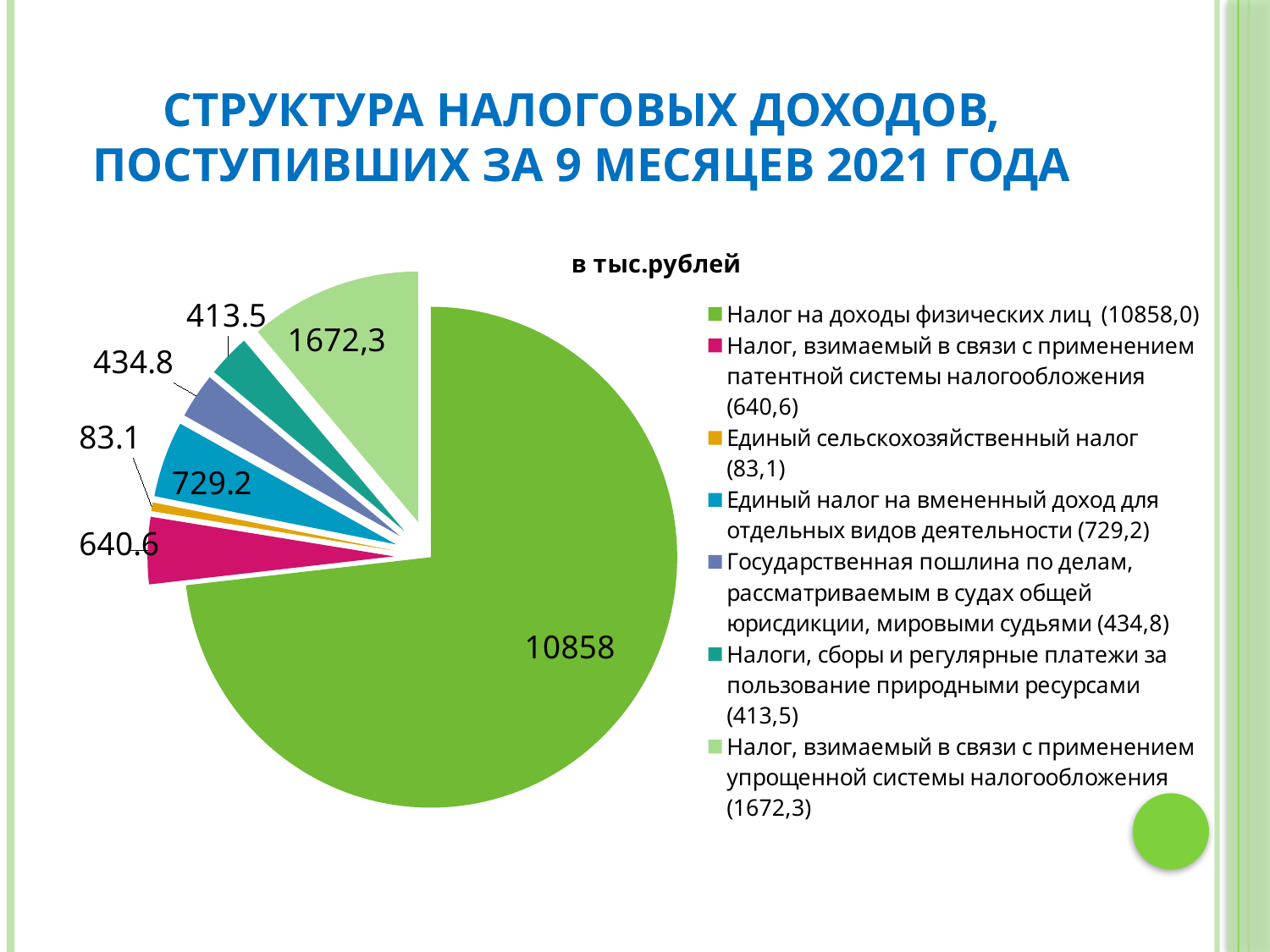
What type of chart is shown on the slide? Pie chart Which is larger: the value for Государственная пошлина по делам, рассматриваемым в судах общей юрисдикции (434.8) or the value for Налоги, сборы и регулярные платежи за пользование природными ресурсами (413.5)? Государственная пошлина по делам, рассматриваемым в судах общей юрисдикции What is the value of the slice for Налог, взимаемый в связи с применением упрощенной системы налогообложения? 1672,3 In what units are the values on the chart given, according to the label above the legend? в тыс.рублей What is the difference between the value for Налог на доходы физических лиц (10858) and the value for Налог, взимаемый в связи с применением упрощенной системы налогообложения (1672,3)? 9185.7 What is the difference between the value for Единый налог на вмененный доход (729.2) and the value for Налог, взимаемый в связи с применением патентной системы налогообложения (640.6)? 88.6 What is the value of the slice for Налог на доходы физических лиц? 10858 What is the value of the slice for Единый сельскохозяйственный налог? 83.1 Which category has the smallest slice of the pie? Единый сельскохозяйственный налог What is the value of the slice for Единый налог на вмененный доход для отдельных видов деятельности? 729.2 How many slices does the pie chart have? 7 Which category has the largest slice of the pie? Налог на доходы физических лиц